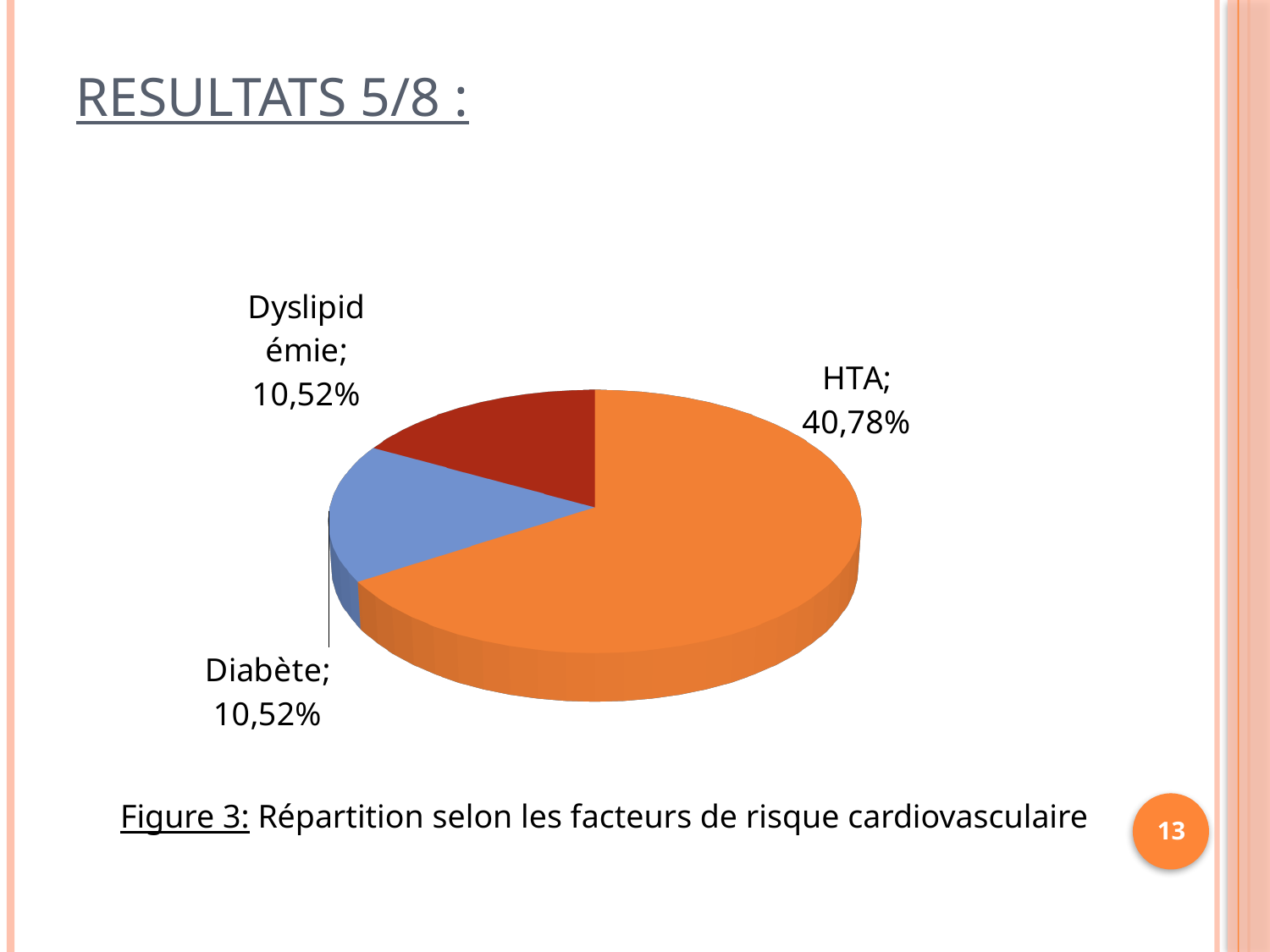
What is the value shown for HTA in the pie chart? 40,78% What share of the pie does HTA represent according to its label? 40,78% What kind of chart is shown on the slide? Pie chart What is the value shown for Dyslipidémie in the pie chart? 10,52% What is the difference between the values for HTA and Diabète? 30,26% Which is larger, the value for HTA or the value for Dyslipidémie? HTA Which category has the largest slice in the pie chart? HTA What is the caption of the figure below the pie chart? Figure 3: Répartition selon les facteurs de risque cardiovasculaire How many slices does the pie chart have? 3 What colour is the HTA slice in the pie chart? Orange What is the value shown for Diabète in the pie chart? 10,52%